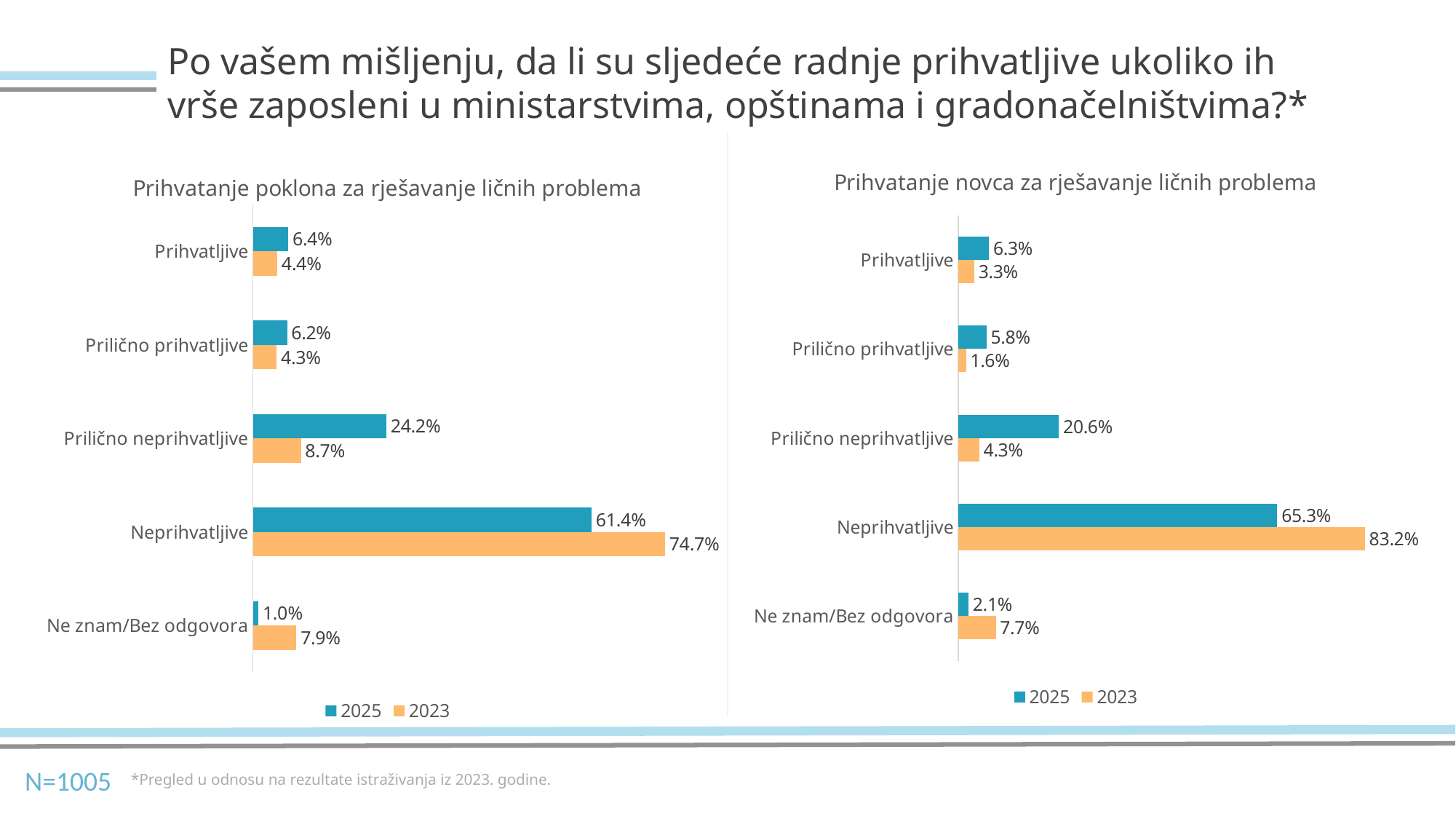
In the chart 'Prihvatanje novca za rješavanje ličnih problema', what is the difference between the 2025 and 2023 values for Prilično neprihvatljive? 16.3% In the chart 'Prihvatanje poklona za rješavanje ličnih problema', which category has the lowest 2025 value? Ne znam/Bez odgovora How many categories are shown in the chart 'Prihvatanje poklona za rješavanje ličnih problema'? 5 In the chart 'Prihvatanje poklona za rješavanje ličnih problema', what is the 2025 value for Neprihvatljive? 61.4% In the chart 'Prihvatanje novca za rješavanje ličnih problema', which category has the highest 2025 value? Neprihvatljive In the chart 'Prihvatanje novca za rješavanje ličnih problema', which colour represents the 2023 series? Orange In the chart 'Prihvatanje novca za rješavanje ličnih problema', which is larger for Ne znam/Bez odgovora: the 2025 value or the 2023 value? 2023 In the chart 'Prihvatanje poklona za rješavanje ličnih problema', what is the difference between the 2023 and 2025 values for Neprihvatljive? 13.3% In the chart 'Prihvatanje poklona za rješavanje ličnih problema', what is the 2023 value for Ne znam/Bez odgovora? 7.9% In the chart 'Prihvatanje novca za rješavanje ličnih problema', what is the 2023 value for Neprihvatljive? 83.2% How many series does the legend list in the chart 'Prihvatanje novca za rješavanje ličnih problema'? 2 What type of chart is 'Prihvatanje poklona za rješavanje ličnih problema'? Bar chart